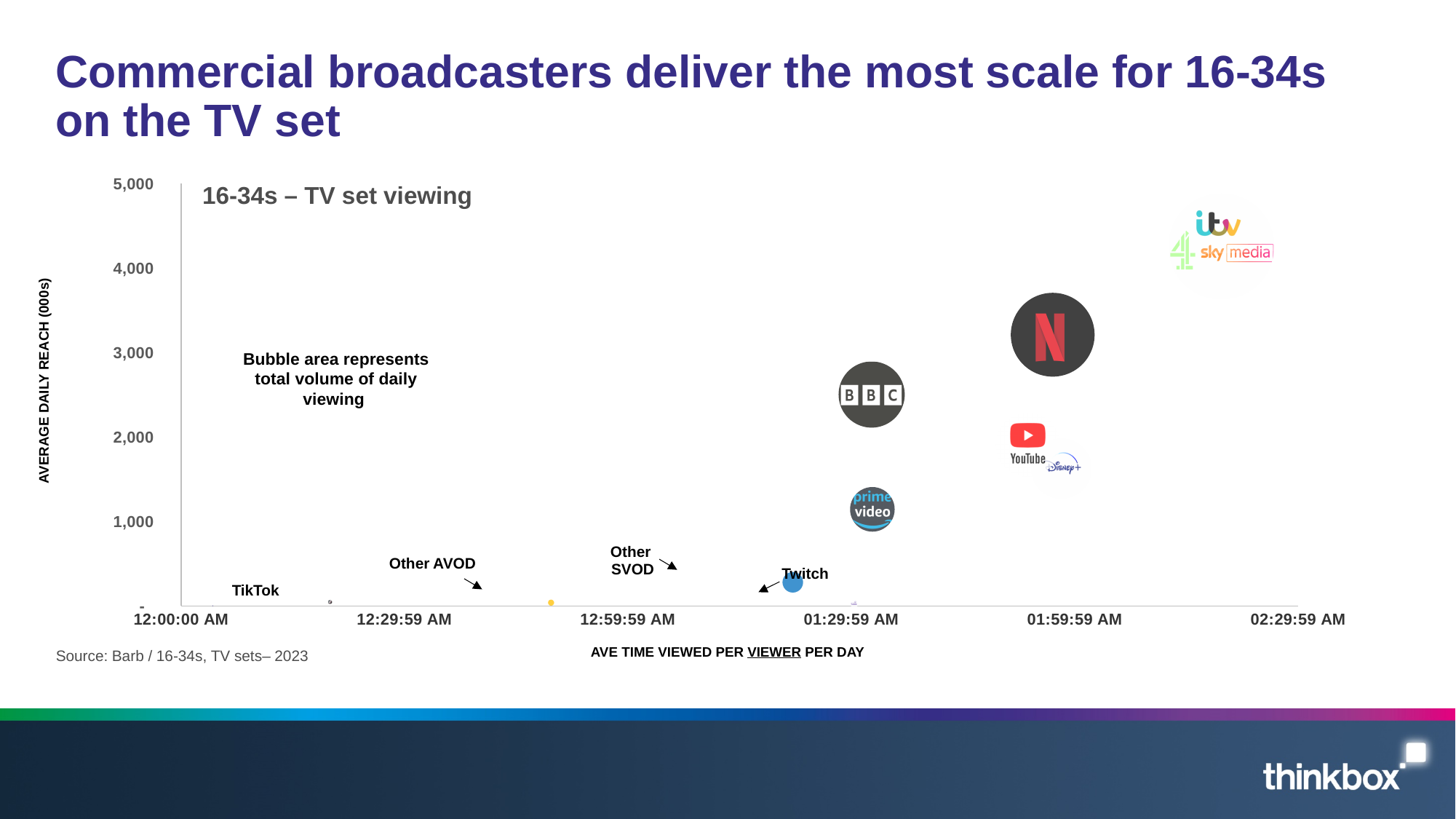
What kind of chart is shown on the slide? Bubble chart What does the bubble area represent in the chart? Total volume of daily viewing Which bubble has the highest average daily reach? Commercial broadcasters (ITV, Channel 4, Sky Media) Is the average daily reach for the commercial broadcasters (ITV, Channel 4, Sky Media) greater or less than 4,000? greater What is the title of the chart? 16-34s – TV set viewing Is the average daily reach for Prime Video greater or less than 2,000? less Which has the higher average daily reach, Prime Video or Twitch? Prime Video Is the average daily reach for BBC greater or less than 3,000? less Which has the higher average daily reach, Netflix or BBC? Netflix